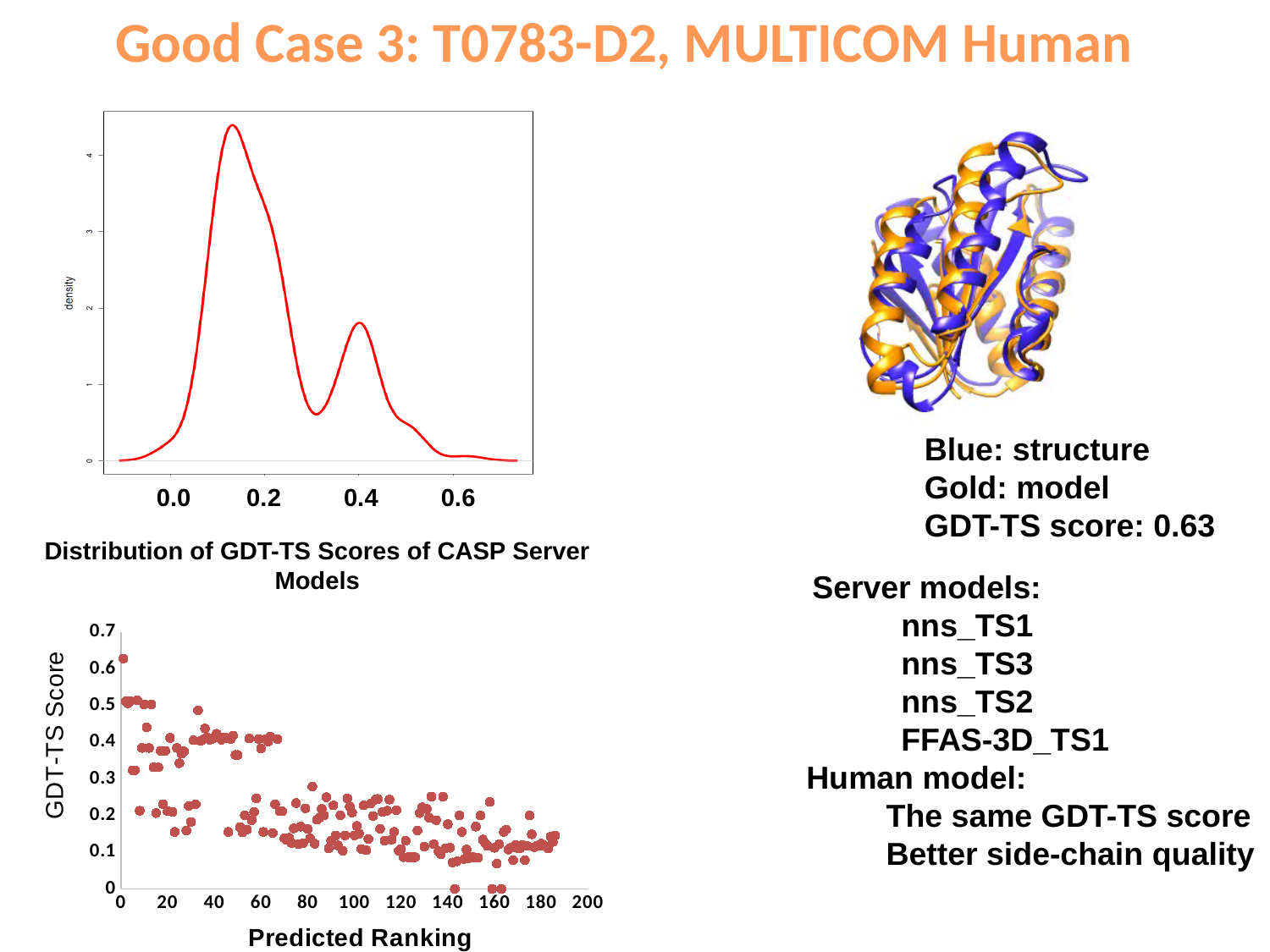
In the top-left density chart, is the density at the smaller second peak (near 0.4) greater or less than 2? less In the top-left density chart, how many peaks does the curve show? 2 What kind of chart is the bottom-left chart with 'Predicted Ranking' on the x axis? scatter plot In the bottom-left scatter plot, is the GDT-TS score of the point at predicted ranking 1 greater or less than 0.5? greater What is the y-axis label of the bottom-left scatter plot? GDT-TS Score In the top-left density chart, is the density at the tallest peak greater or less than 4? greater In the bottom-left scatter plot, what is the highest value shown on the y axis? 0.7 What kind of chart is the top-left chart titled 'Distribution of GDT-TS Scores of CASP Server Models'? line chart In the bottom-left scatter plot, do GDT-TS scores generally rise or fall as the predicted ranking increases? fall What is the title of the top-left chart? Distribution of GDT-TS Scores of CASP Server Models